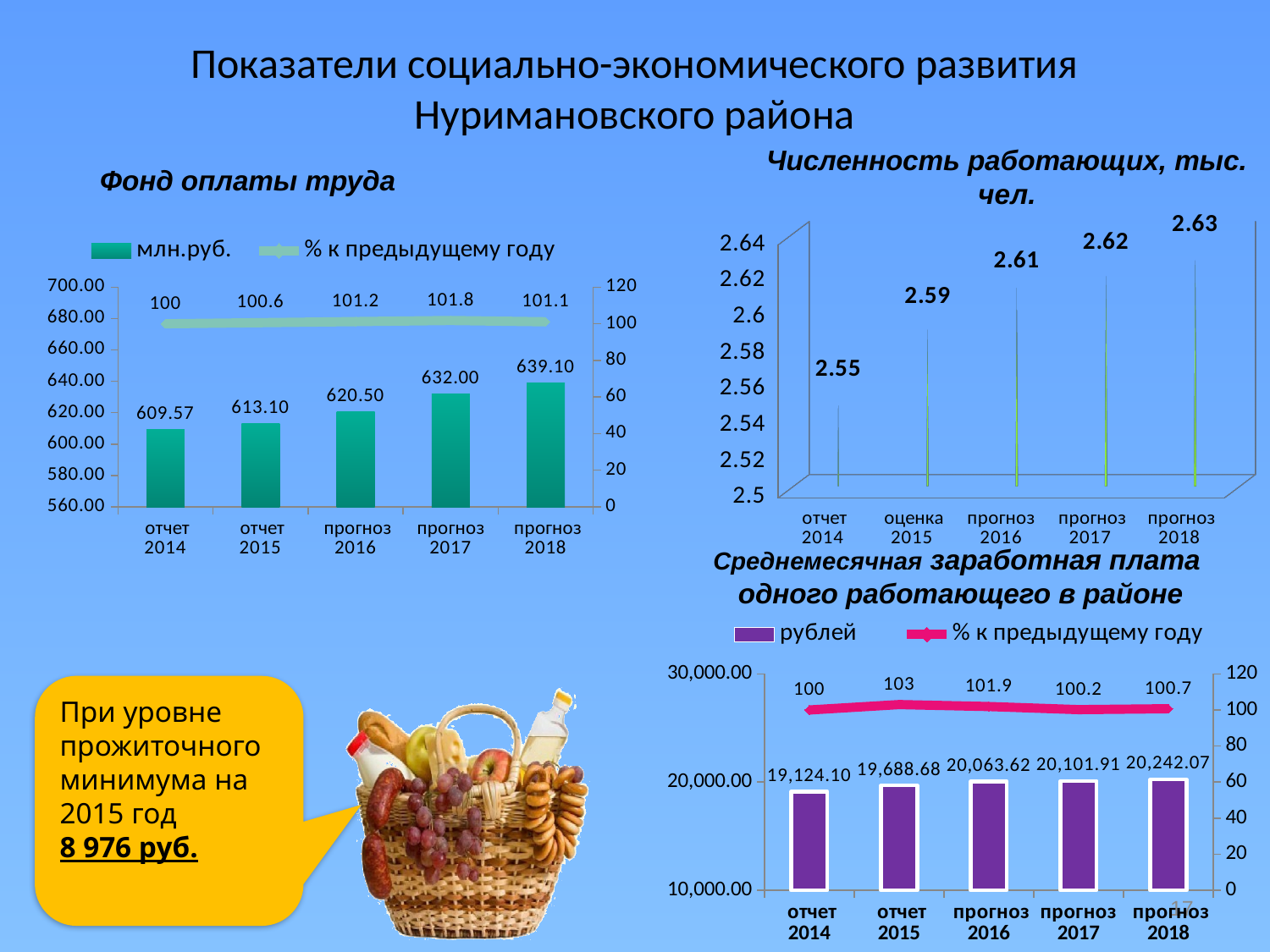
In the 'Численность работающих, тыс. чел.' chart, which year has the highest value? прогноз 2018 In the 'Среднемесячная заработная плата одного работающего в районе' chart, is the рублей value for отчет 2014 greater or less than 20,000.00? less In the 'Фонд оплаты труда' chart, which year has the lowest млн.руб. value? отчет 2014 In the 'Фонд оплаты труда' chart, what is the difference in млн.руб. between прогноз 2018 and отчет 2014? 29.53 In the 'Численность работающих, тыс. чел.' chart, what is the value for оценка 2015? 2.59 In the 'Фонд оплаты труда' chart, what is the value in млн.руб. for прогноз 2018? 639.10 In the 'Среднемесячная заработная плата одного работающего в районе' chart, what is the рублей value for прогноз 2016? 20,063.62 In the 'Фонд оплаты труда' chart, what is the '% к предыдущему году' value for прогноз 2017? 101.8 In the 'Численность работающих, тыс. чел.' chart, do the values rise or fall from отчет 2014 to прогноз 2018? rise In the 'Численность работающих, тыс. чел.' chart, how many categories are shown on the x axis? 5 In the 'Фонд оплаты труда' chart, how many series does the legend list? 2 In the 'Среднемесячная заработная плата одного работающего в районе' chart, which year has the highest '% к предыдущему году' value? отчет 2015